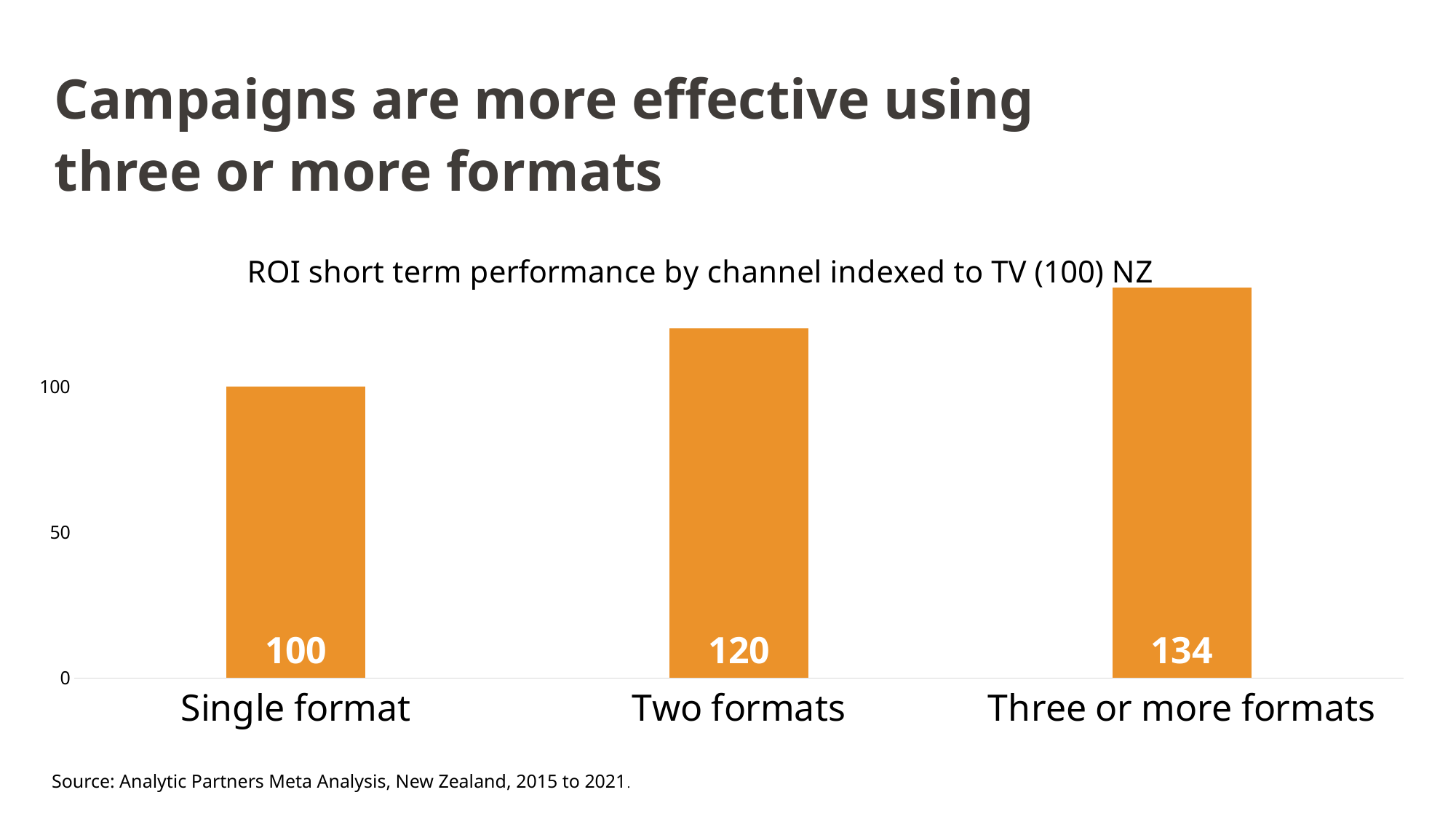
Do the values rise or fall from Single format to Three or more formats? rise How many categories are shown on the chart? 3 What is the value for Two formats? 120 What is the difference between the values for Two formats and Single format? 20 What is the difference between the values for Three or more formats and Single format? 34 Is the value for Two formats greater or less than 100? greater Which category has the lowest value? Single format What is the value for Single format? 100 What kind of chart is shown on the slide? bar chart Which category has the highest value? Three or more formats Which is larger, the value for Two formats or the value for Three or more formats? Three or more formats What is the value for Three or more formats? 134